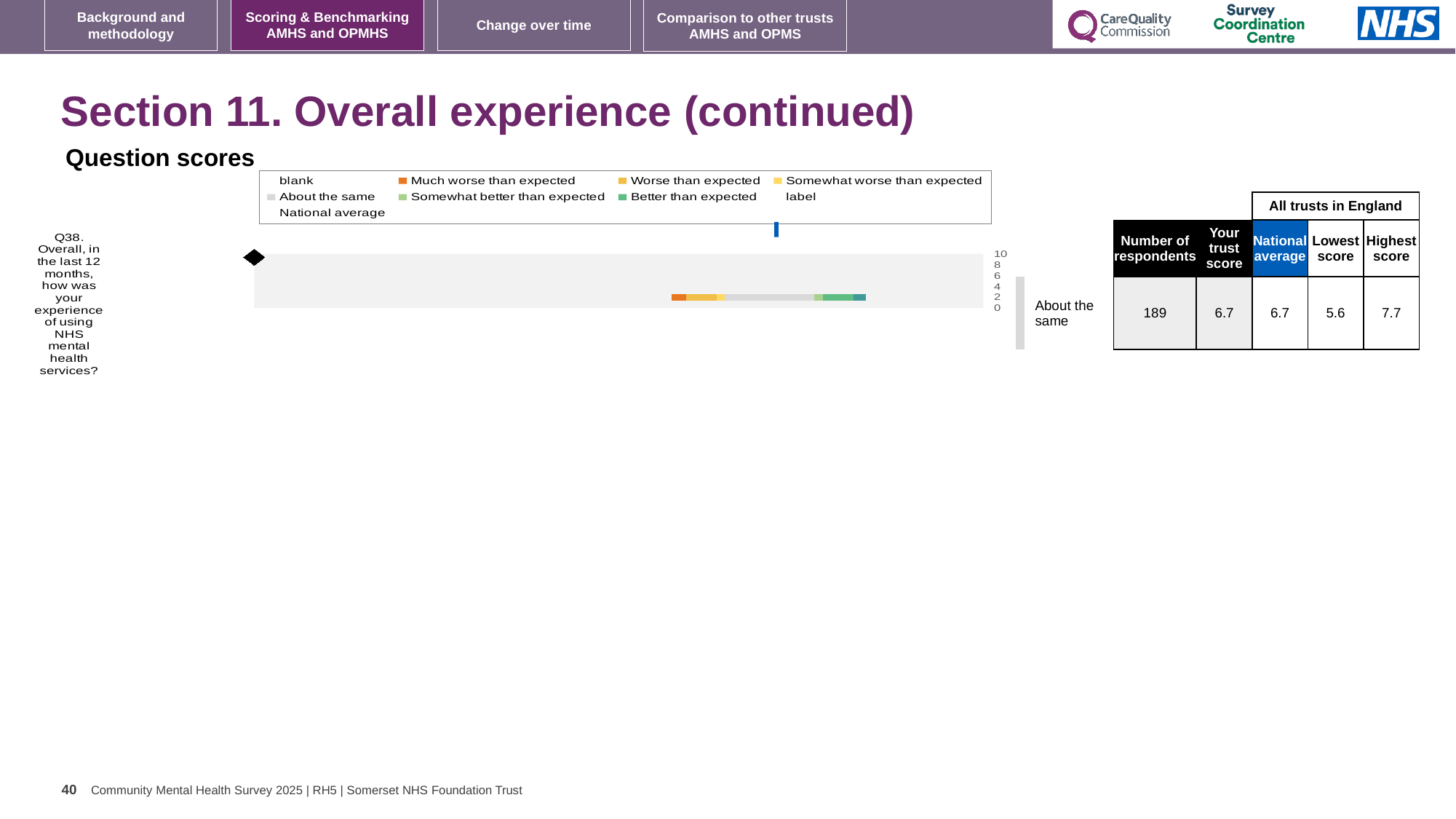
Which question number is plotted in the chart? Q38 What kind of chart is shown under 'Question scores'? bar chart What is the number of respondents for Q38? 189 What is the lowest score among all trusts in England for Q38? 5.6 What is the difference between the highest score and the lowest score for Q38? 2.1 How many questions (categories) are plotted in the chart? 1 What category label is given next to the chart for Q38's comparison to other trusts? About the same What is the highest tick value shown on the chart's axis? 10 What is the highest score among all trusts in England for Q38? 7.7 What is 'Your trust score' for Q38? 6.7 Is the trust score for Q38 larger than, smaller than, or equal to the national average? equal What is the national average score for Q38? 6.7